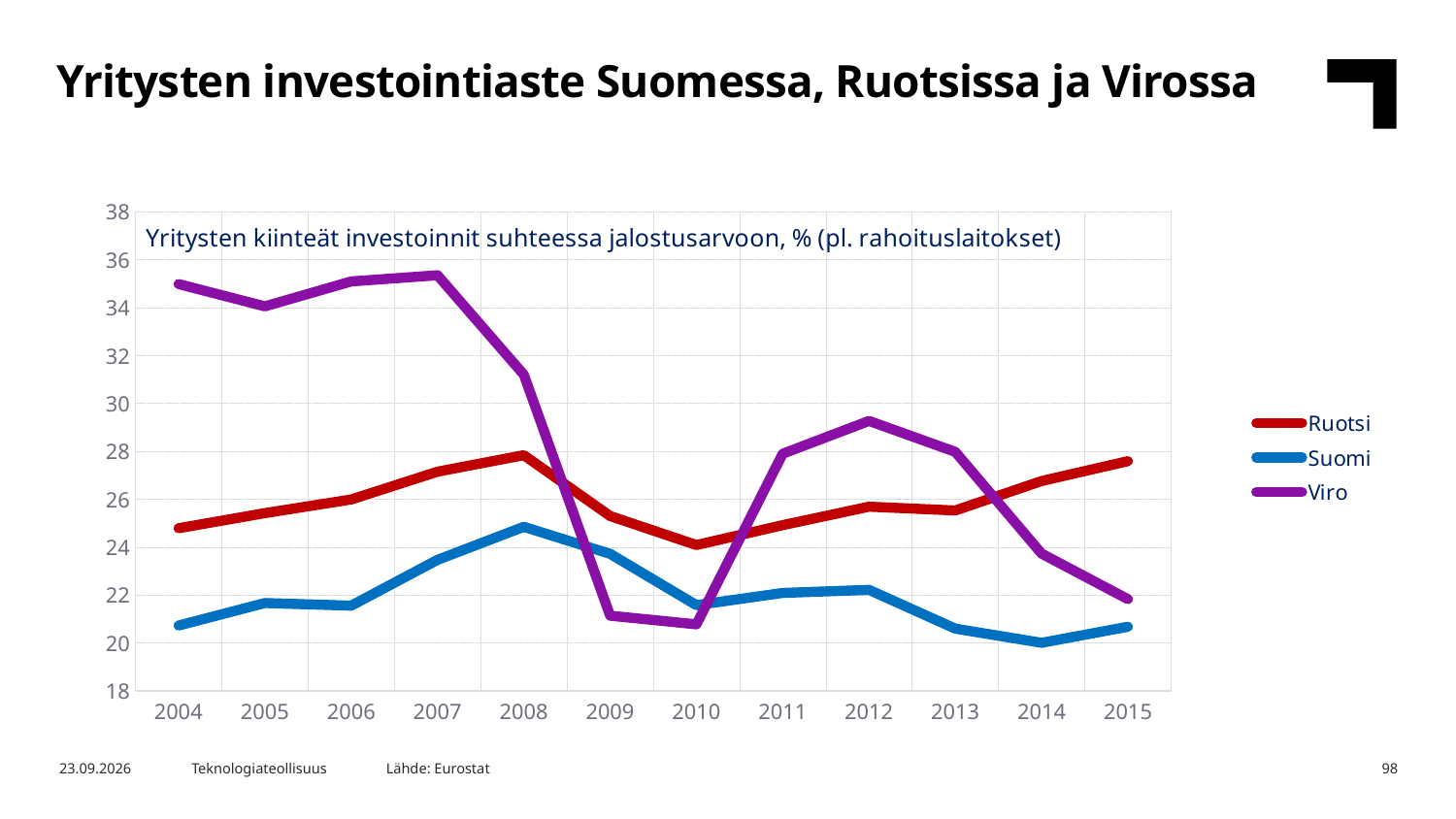
What kind of chart is shown on the slide? line chart Which is larger in 2015, the value for Ruotsi or the value for Viro? Ruotsi Is the value for Viro in 2012 greater or less than 28? greater Is the value for Suomi in 2008 greater or less than 24? greater How many series does the legend list? 3 How many years are shown on the x axis? 12 Which series has the lowest value in 2015? Suomi Is the value for Ruotsi in 2010 greater or less than 26? less Which series has the highest value in 2004? Viro Which series is drawn in purple? Viro Does the value for Viro rise or fall from 2007 to 2009? fall